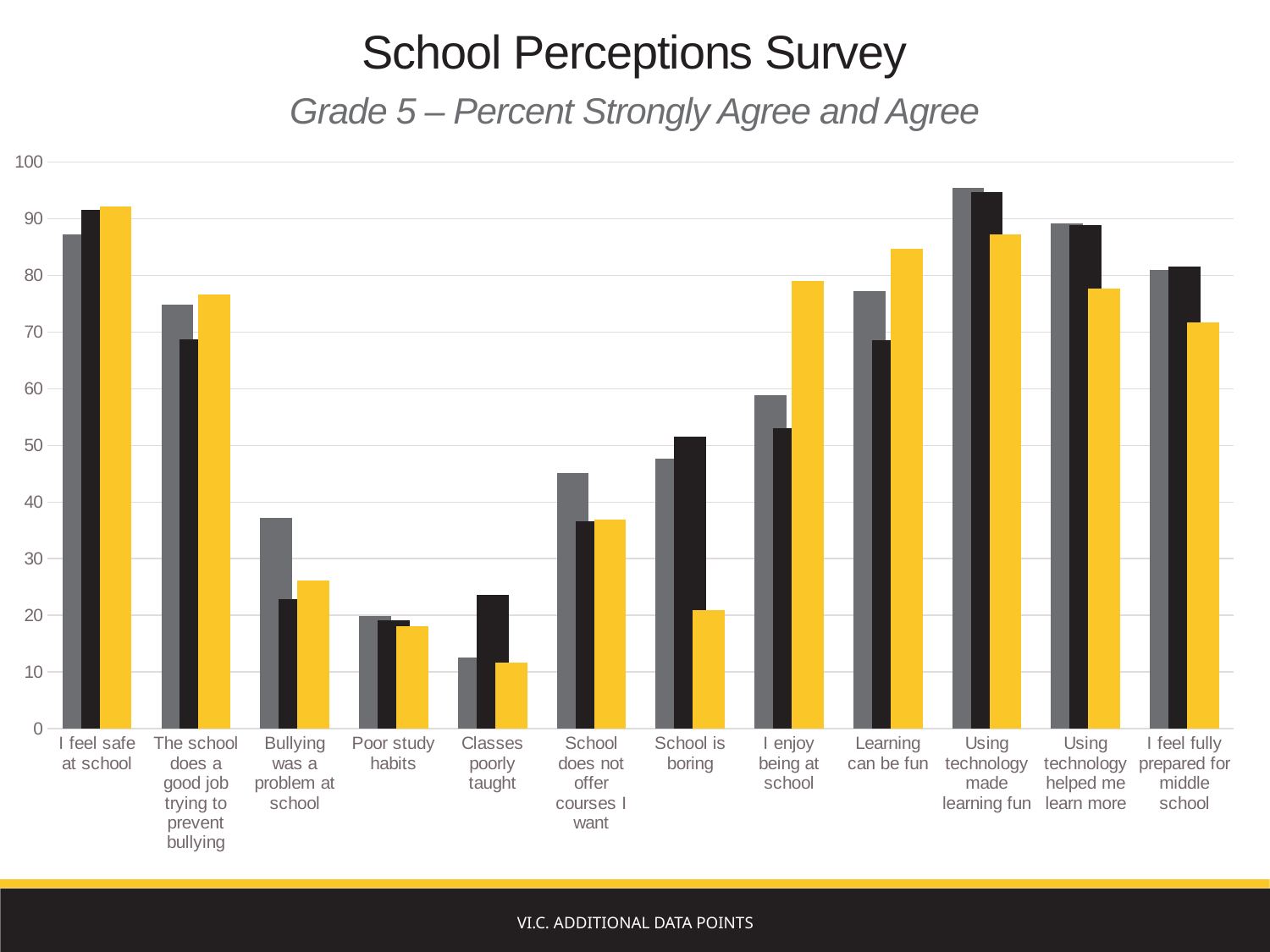
Is the gray bar for "Using technology made learning fun" greater or less than 90? greater What is the title of the chart? School Perceptions Survey Which is larger: the yellow bar for "I enjoy being at school" or the yellow bar for "School is boring"? I enjoy being at school Which statement has the highest gray bar? Using technology made learning fun Is the gray bar for "Bullying was a problem at school" greater or less than 40? less Which statement has the lowest gray bar? Classes poorly taught Which statement has the lowest yellow bar? Classes poorly taught How many survey statements (categories) are shown along the x axis? 12 Is the yellow bar for "I feel safe at school" greater or less than 80? greater What does the subtitle say the chart measures? Grade 5 – Percent Strongly Agree and Agree What kind of chart is shown on the slide? bar chart